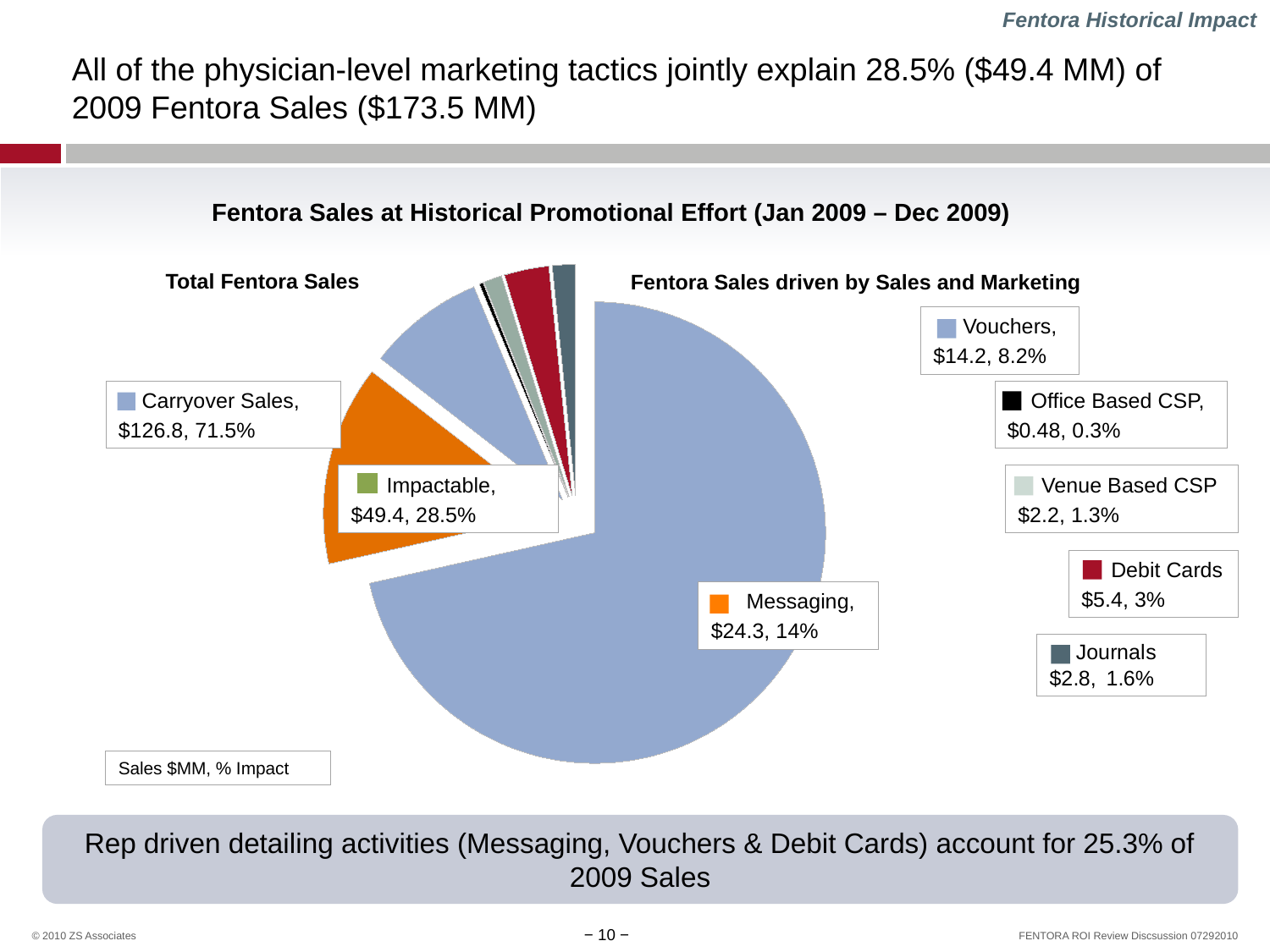
What kind of chart is shown on the slide? pie chart What is the difference in sales value between Messaging and Vouchers? $10.1 What is the title of the chart? Fentora Sales at Historical Promotional Effort (Jan 2009 – Dec 2009) What percentage share is shown for Vouchers? 8.2% Which slice of the pie is the largest? Carryover Sales Which is larger, the sales value for Vouchers or for Debit Cards? Vouchers What is the sales value shown for Office Based CSP? $0.48 What is the sales value shown for Messaging? $24.3 What percentage share is shown for Debit Cards? 3% What is the sales value shown for Carryover Sales? $126.8 What percentage share is shown for Carryover Sales? 71.5% Which slice of the pie is the smallest? Office Based CSP